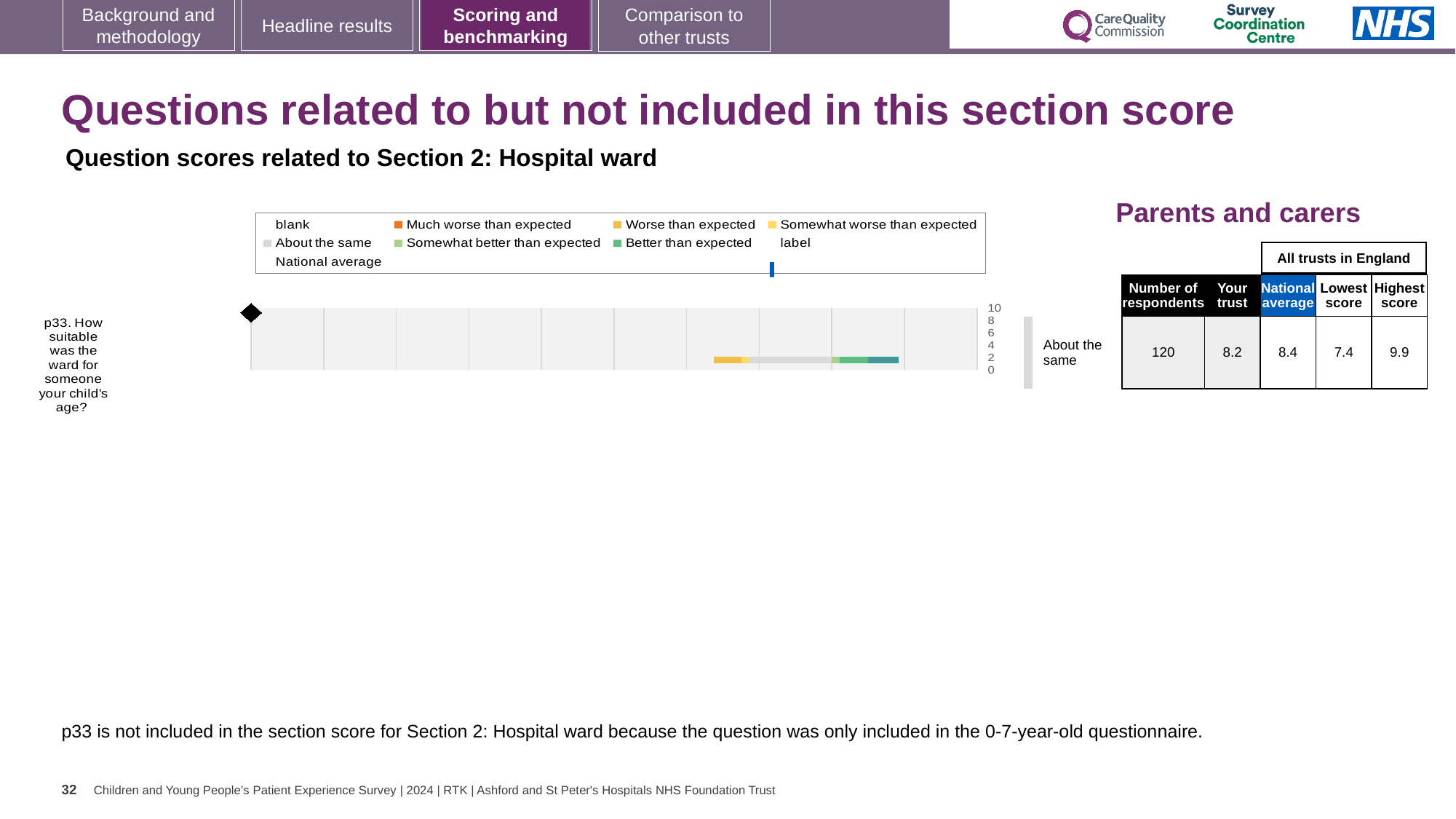
Which question is plotted in the chart? p33. How suitable was the ward for someone your child's age? What is the 'Your trust' score for p33 in the table beside the chart? 8.2 What is the difference between the highest and lowest scores among all trusts in England for p33? 2.5 What is the lowest score among all trusts in England for p33? 7.4 What is the highest value shown on the chart's axis? 10 How many respondents answered p33? 120 What is the national average score for p33? 8.4 What comparison category is shown next to the bar for p33? About the same Which is larger for p33, the trust's score or the national average? national average What kind of chart is shown on the slide? bar chart How many questions (categories) are plotted in the chart? 1 What is the highest score among all trusts in England for p33? 9.9